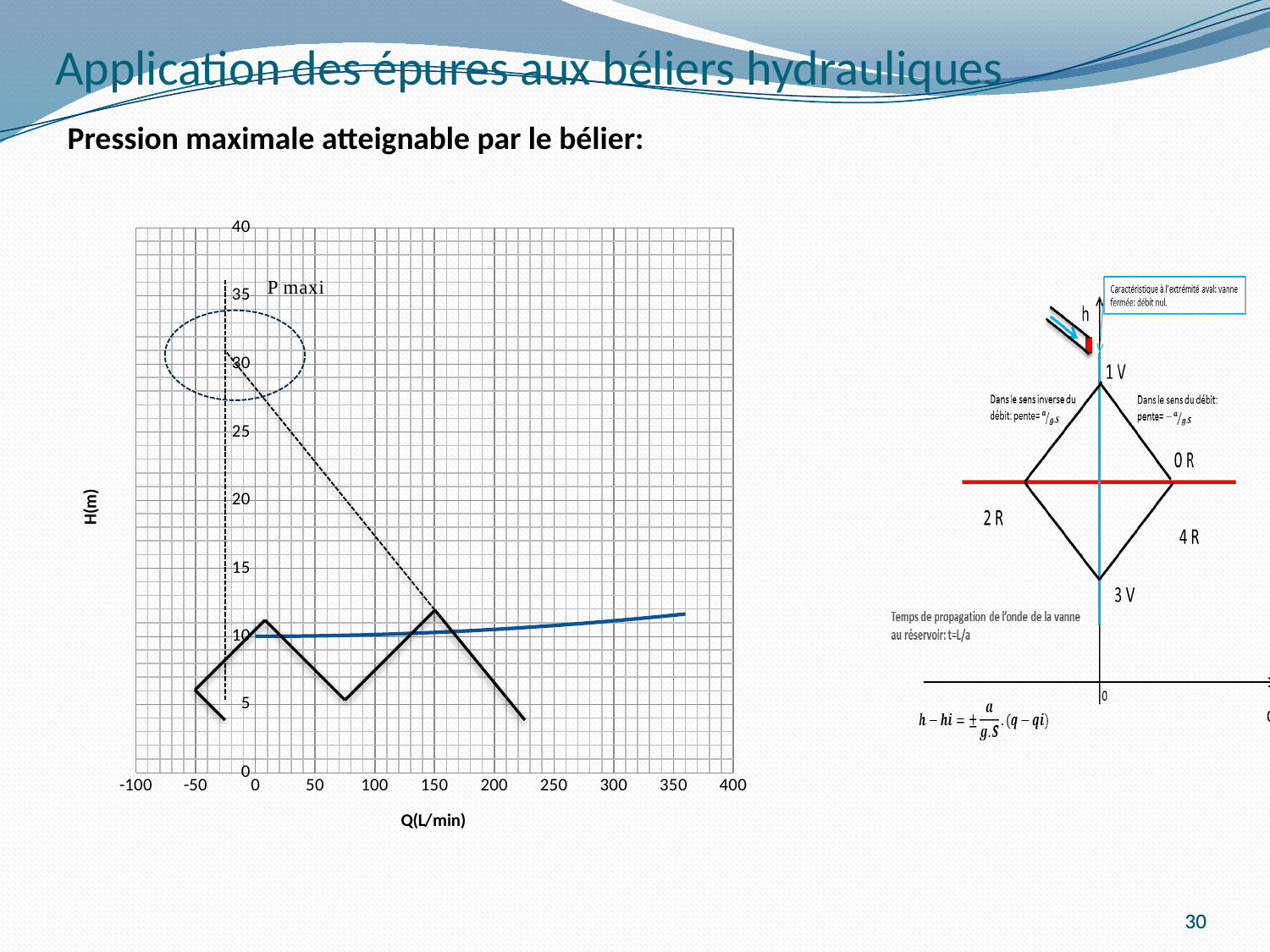
What is the label of the y axis of the chart? H(m) Is the end of the black zigzag line near Q = 225 greater or less than 10 on the H axis? less What kind of chart is shown on the left of the slide? line chart How many tick labels are shown on the x axis of the chart? 11 What is the lowest value shown on the x axis of the chart? -100 What is the highest value shown on the x axis of the chart? 400 What is the highest value shown on the y axis of the chart? 40 Is the peak of the black zigzag line near Q = 150 greater or less than 10 on the H axis? greater Is the H value of the point marked "P maxi" greater or less than 25? greater What is the label of the x axis of the chart? Q(L/min) Does the blue curve rise or fall as Q increases from 0 to 350? rises